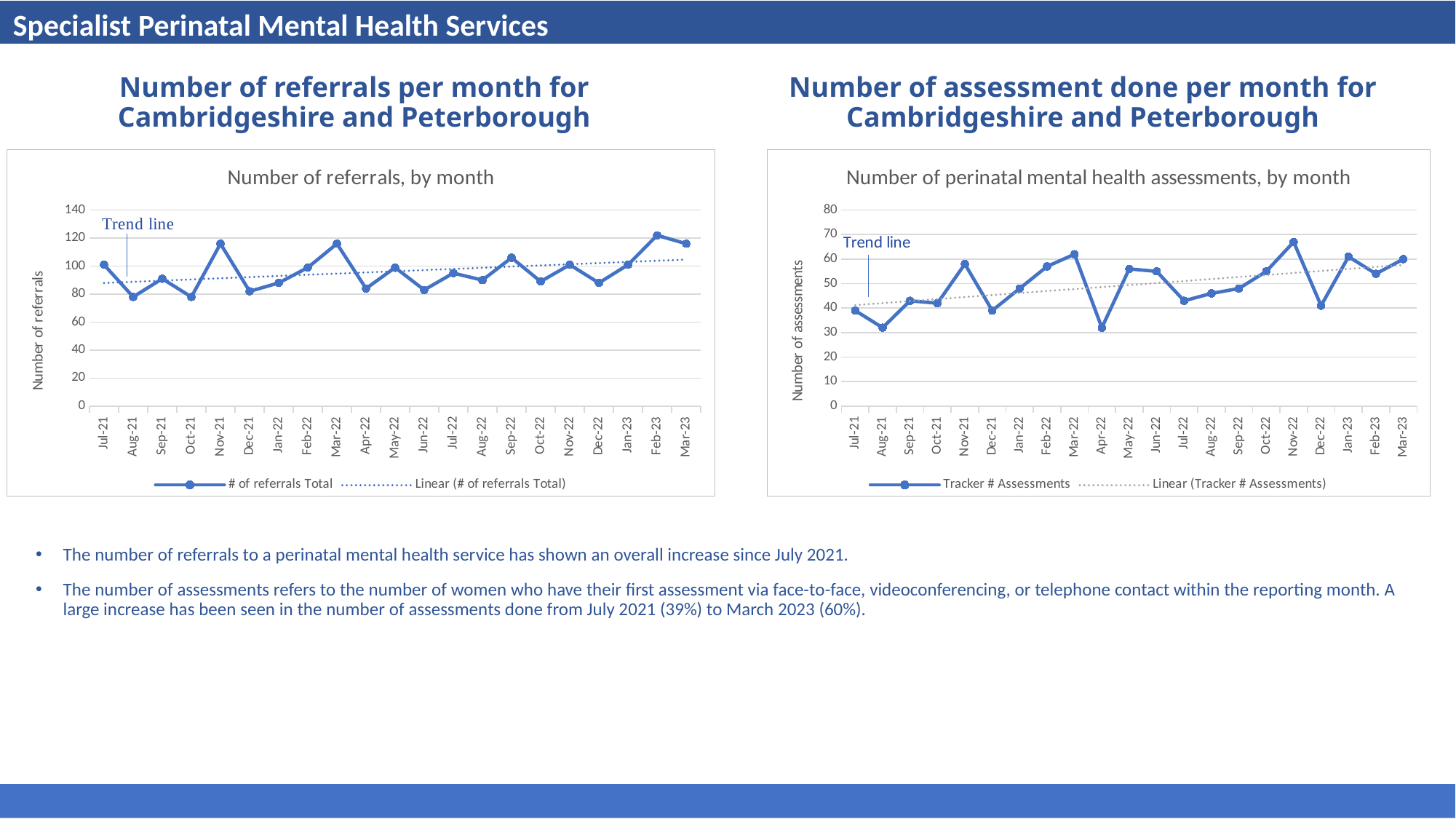
In the left chart (Number of referrals, by month), is the value for Jun-22 greater or less than 100? less How many entries does the legend of the right chart (Number of perinatal mental health assessments, by month) list? 2 How many months are plotted on the x axis of the left chart (Number of referrals, by month)? 21 What kind of chart is the 'Number of referrals, by month' chart on the left? line chart According to the trend line in the right chart (Number of perinatal mental health assessments, by month), do assessments rise or fall overall from Jul-21 to Mar-23? rise In the right chart (Number of perinatal mental health assessments, by month), is the value for Nov-22 greater or less than 60? greater In the right chart (Number of perinatal mental health assessments, by month), which month has more assessments, Mar-22 or Apr-22? Mar-22 In the left chart (Number of referrals, by month), which month has more referrals, Nov-21 or Dec-21? Nov-21 In the left chart (Number of referrals, by month), is the value for Nov-21 greater or less than 100? greater In the left chart (Number of referrals, by month), which month has the highest number of referrals? Feb-23 In the right chart (Number of perinatal mental health assessments, by month), which month has the highest number of assessments? Nov-22